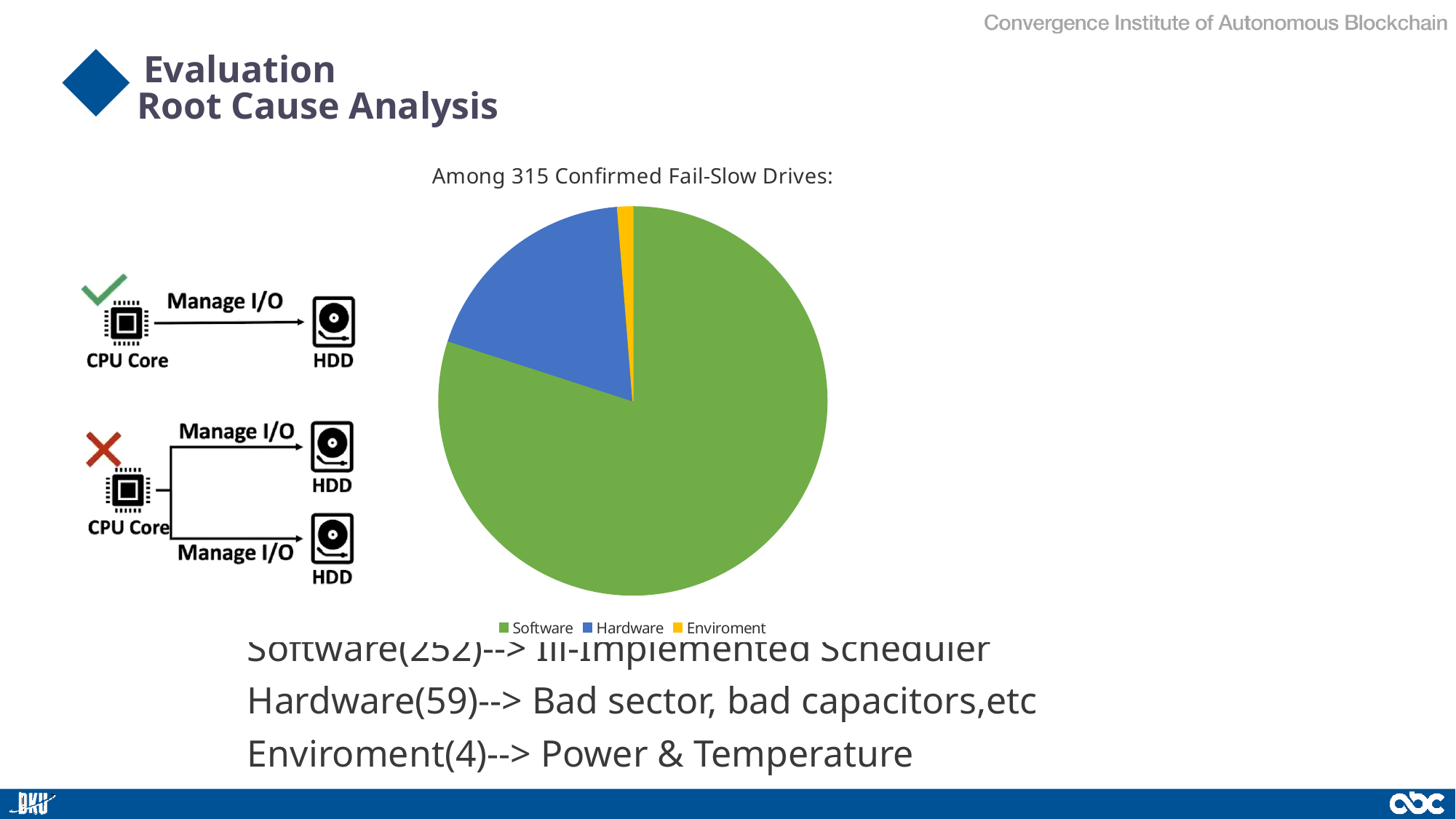
What share of the 315 confirmed fail-slow drives is attributed to Software? 80% Which category has the largest slice of the pie chart? Software What is the difference between the Software count and the Hardware count? 193 Which colour represents Hardware in the pie chart? blue How many drives are attributed to Hardware according to the slide? 59 How many categories does the pie chart's legend list? 3 How many drives are attributed to Software according to the slide? 252 Which category has the smallest slice of the pie chart? Enviroment How many drives are attributed to Enviroment according to the slide? 4 What is the title of the pie chart? Among 315 Confirmed Fail-Slow Drives: Which slice is larger, Hardware or Enviroment? Hardware What kind of chart is shown on the slide? pie chart